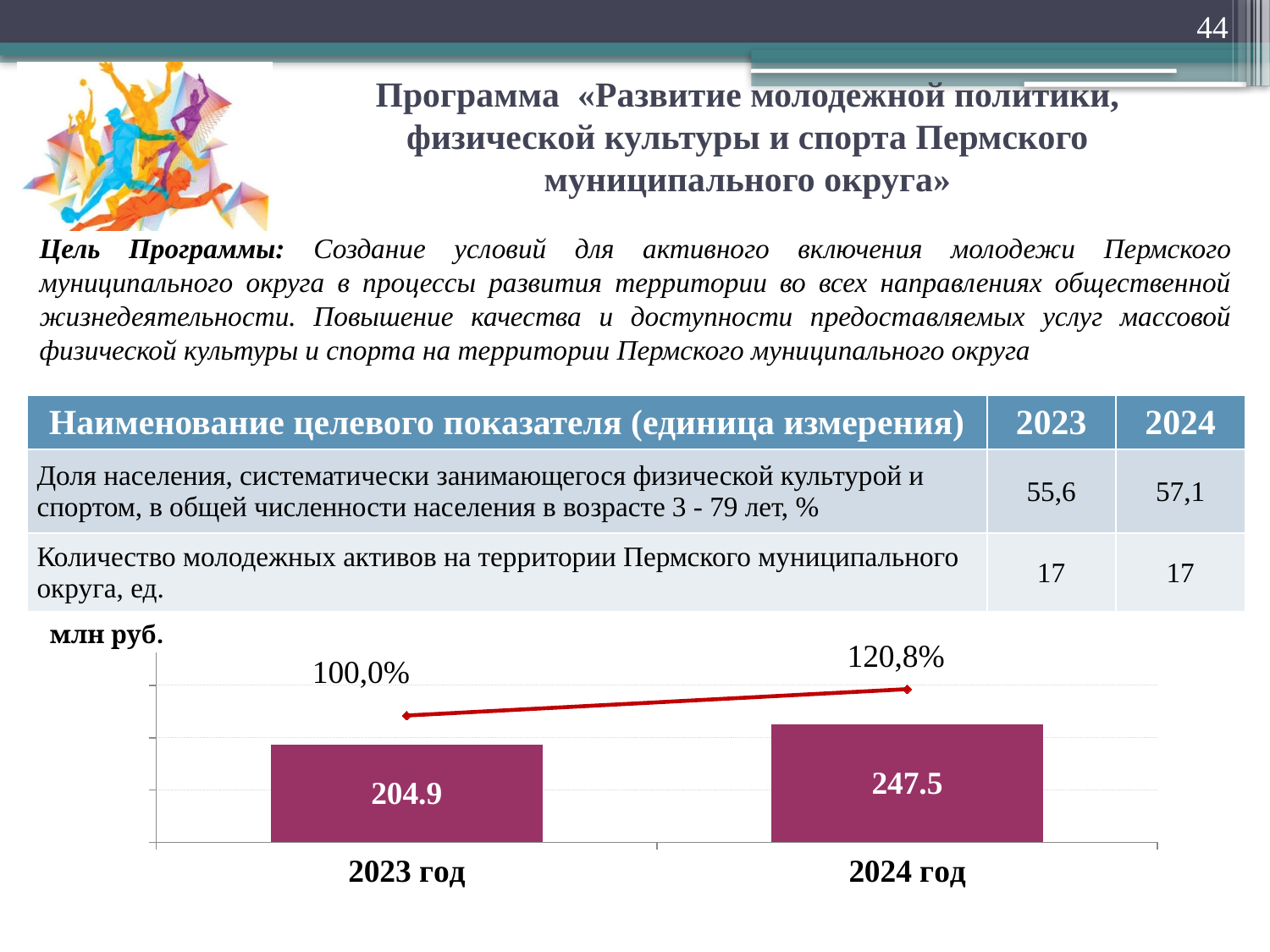
What is the value for 2023 год on the chart? 204.9 What percentage label is shown above the 2024 год bar on the line? 120,8% What kind of chart is shown on the slide? combination bar and line chart Is the value for 2024 год larger or smaller than the value for 2023 год? larger What is the value for 2024 год on the chart? 247.5 Which year has the higher bar on the chart? 2024 год How many bars are shown on the chart? 2 Do the bar values rise or fall from 2023 год to 2024 год? rise Which year has the lower bar on the chart? 2023 год What unit is indicated above the chart? млн руб. What percentage label is shown above the 2023 год bar on the line? 100,0% What is the difference between the 2024 год and 2023 год values on the chart? 42.6